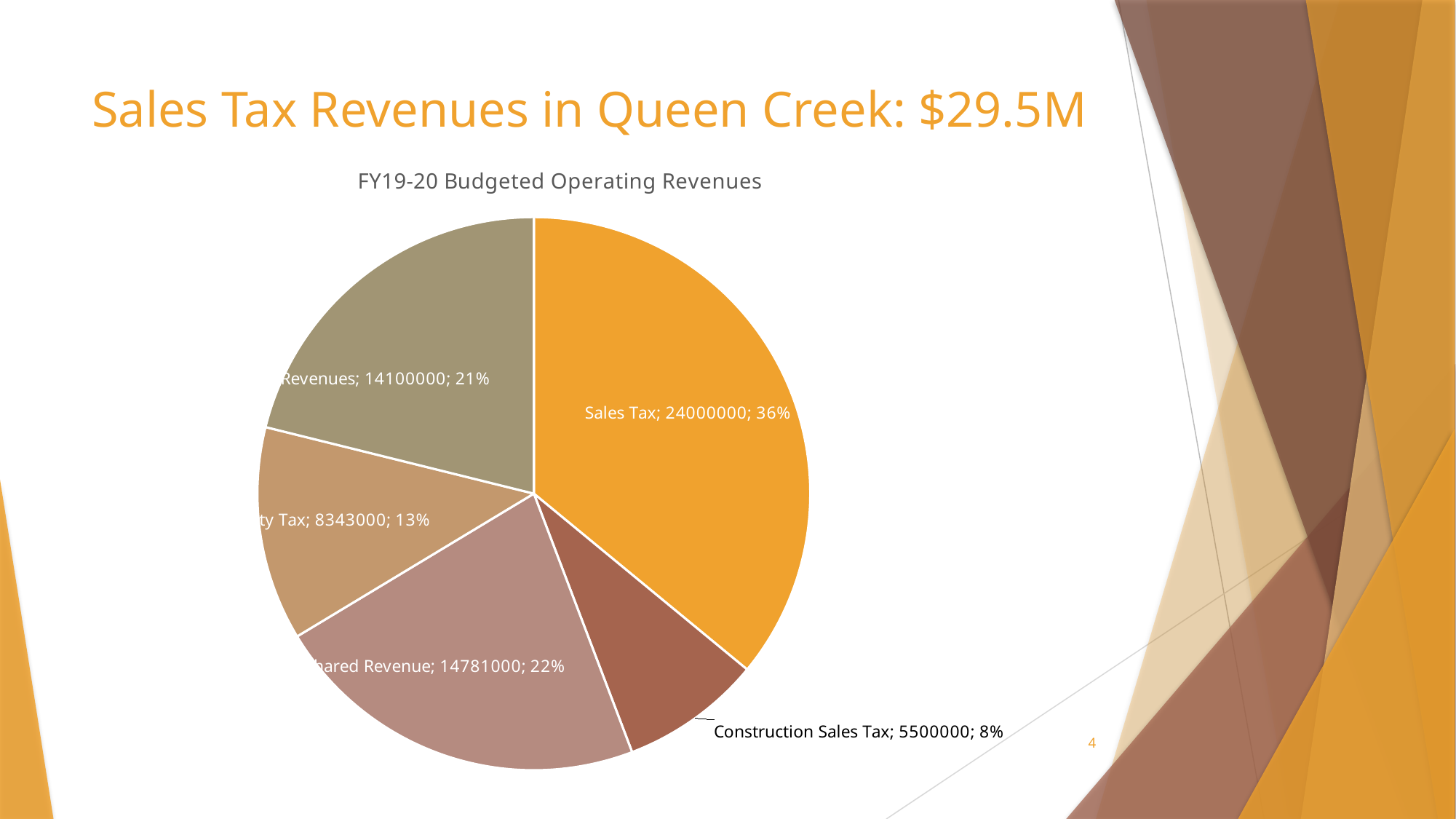
What is the difference between the Sales Tax value and the Construction Sales Tax value? 18500000 What is the value shown for Sales Tax? 24000000 What is the value shown for Construction Sales Tax? 5500000 What type of chart is shown on the slide? Pie chart What share of the pie does Construction Sales Tax represent? 8% Which is larger, Sales Tax or Construction Sales Tax? Sales Tax Which slice is the smallest in the pie chart? Construction Sales Tax How many slices does the pie chart have? 5 What colour is the Sales Tax slice? Orange What is the title of the chart? FY19-20 Budgeted Operating Revenues Which slice is the largest in the pie chart? Sales Tax What share of the pie does Sales Tax represent? 36%